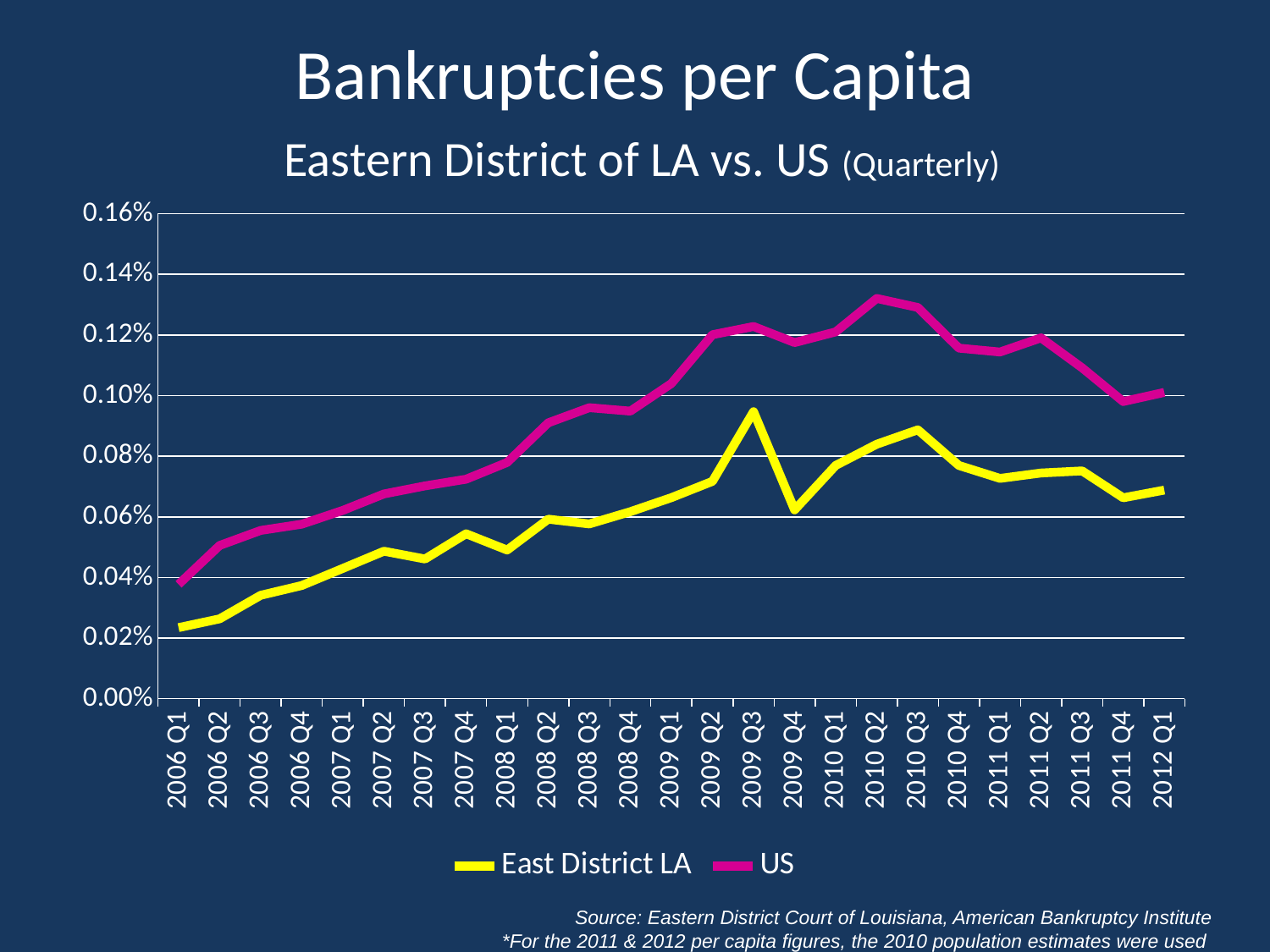
Is the US value for 2010 Q2 greater or less than 0.12%? greater Does the US series rise or fall from 2010 Q2 to 2011 Q4? Fall In which quarter does the East District LA series reach its highest value? 2009 Q3 Is the East District LA value for 2009 Q4 greater or less than 0.08%? less How many quarters are plotted along the x axis? 25 Is the East District LA value for 2006 Q1 greater or less than 0.04%? less What kind of chart is shown on the slide? Line chart In which quarter does the US series reach its highest value? 2010 Q2 In which quarter is the East District LA series at its lowest value? 2006 Q1 Which series has the larger value in 2010 Q2, East District LA or US? US How many series does the legend list? 2 Which colour is used for the East District LA line? Yellow